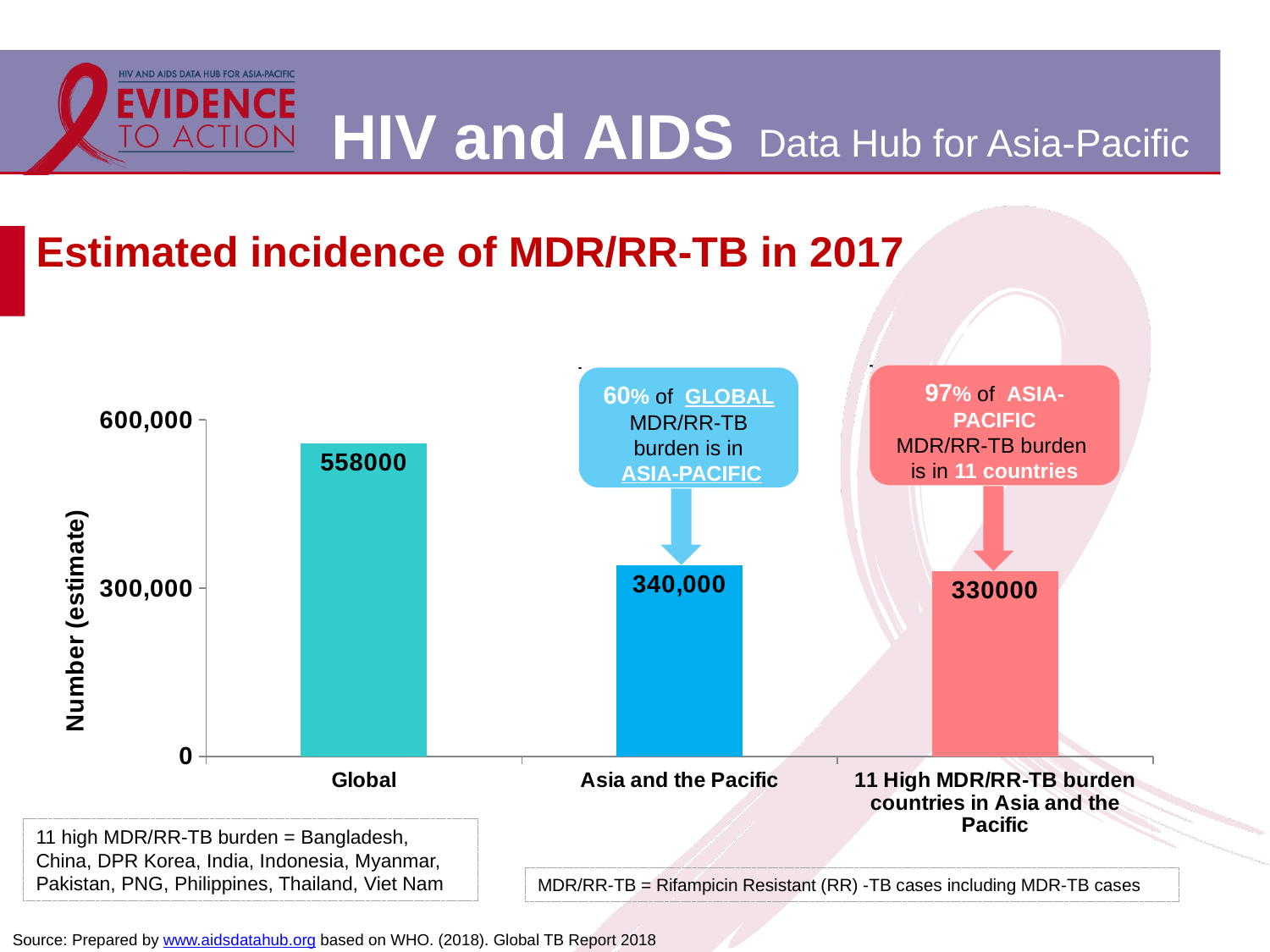
Is the value for Global greater or less than 300,000? greater What is the value shown for Asia and the Pacific? 340,000 What is the difference between the Global value and the Asia and the Pacific value? 218,000 What is the title of the y axis? Number (estimate) Which category has the lowest estimated incidence? 11 High MDR/RR-TB burden countries in Asia and the Pacific Which is larger, the value for Asia and the Pacific or the value for the 11 High MDR/RR-TB burden countries? Asia and the Pacific What is the value shown for the 11 High MDR/RR-TB burden countries in Asia and the Pacific? 330000 What is the estimated incidence of MDR/RR-TB for Global in 2017? 558000 Which category has the highest estimated incidence? Global What is the difference between the Asia and the Pacific value and the value for the 11 High MDR/RR-TB burden countries? 10,000 How many categories are shown on the x axis? 3 What kind of chart is shown on the slide? Bar chart